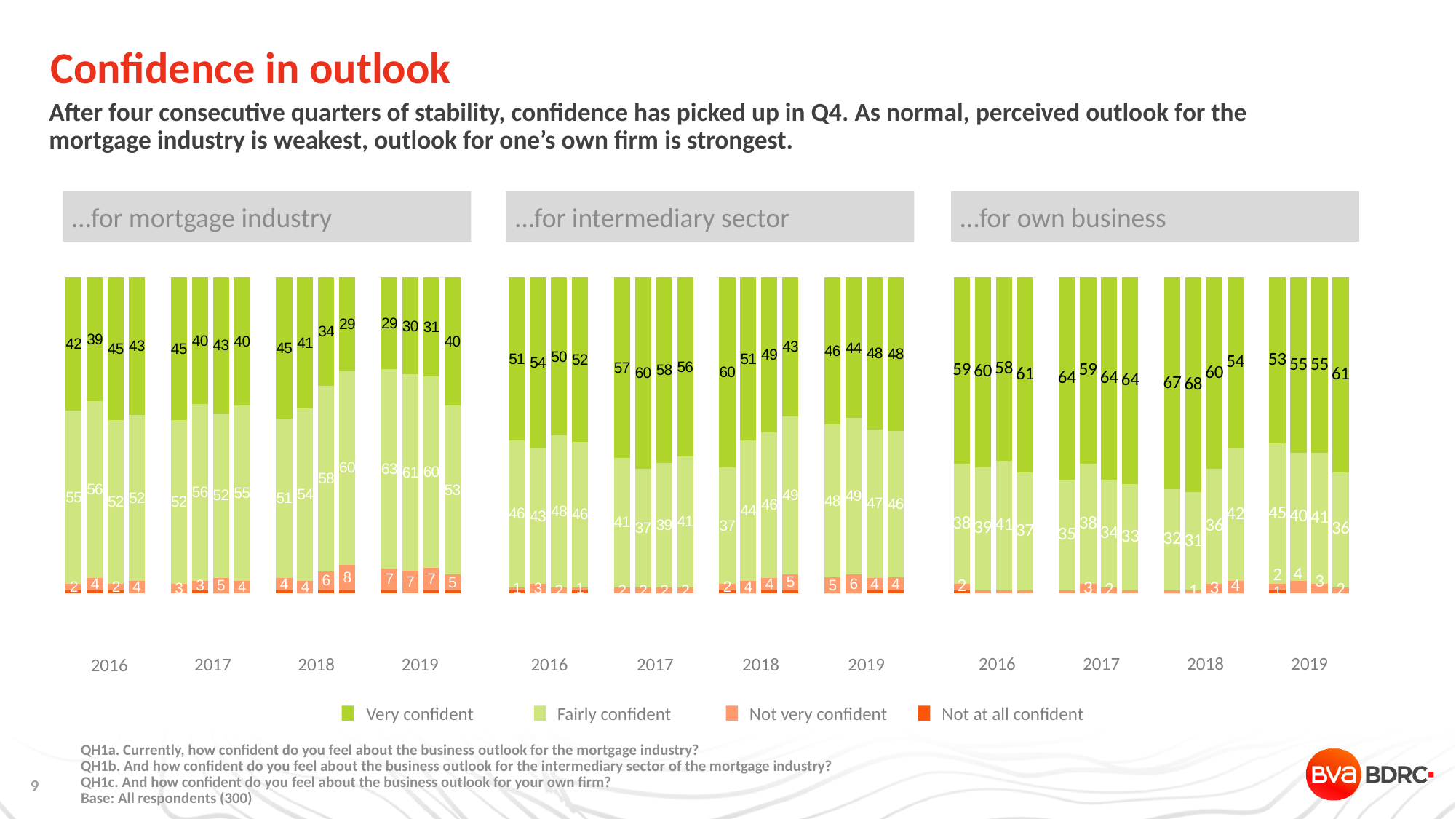
In the '...for own business' chart, what is the 'Fairly confident' value for the first bar of 2019? 45 In the '...for mortgage industry' chart, what is the difference between the 'Very confident' values of the last bar of 2019 and the first bar of 2019? 11 Which legend entry is shown in orange? Not very confident What kind of chart is used for the '...for own business' panel? Stacked bar chart How many series does the legend list? 4 In the '...for own business' chart, what is the highest 'Very confident' value shown? 68 How many bars are plotted in the '...for intermediary sector' chart? 16 In the '...for mortgage industry' chart, what is the 'Very confident' value for the last bar of 2019? 40 In the '...for mortgage industry' chart, what is the lowest 'Very confident' value shown? 29 In the '...for mortgage industry' chart, do the 'Very confident' values rise or fall across the four bars of 2018? Fall In the '...for intermediary sector' chart, what is the 'Not very confident' value for the second bar of 2019? 6 In the '...for own business' chart, which has the larger 'Very confident' value: the first bar of 2018 or the last bar of 2018? The first bar of 2018